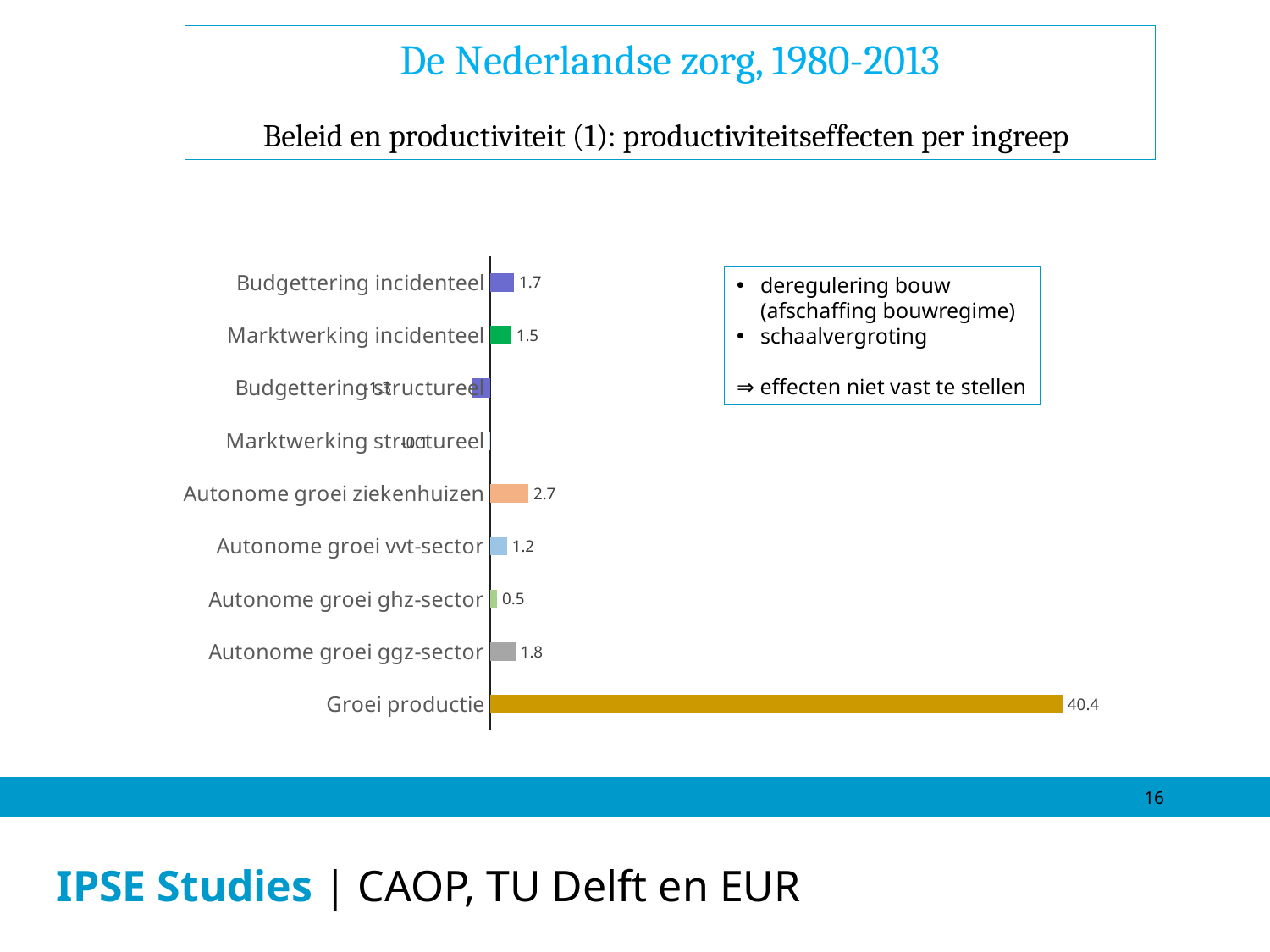
What is the value for Budgettering incidenteel? 1.7 How many categories are plotted in the chart? 9 Which is larger, Autonome groei ggz-sector or Autonome groei ghz-sector? Autonome groei ggz-sector What is the value for Marktwerking incidenteel? 1.5 What is the difference between Autonome groei ziekenhuizen and Autonome groei vvt-sector? 1.5 What is the value for Autonome groei ghz-sector? 0.5 What is the difference between Groei productie and Autonome groei ziekenhuizen? 37.7 What is the value for Groei productie? 40.4 What is the value for Autonome groei ziekenhuizen? 2.7 Which category has the highest value? Groei productie What kind of chart is shown on the slide? bar chart What is the title of the slide containing the chart? De Nederlandse zorg, 1980-2013